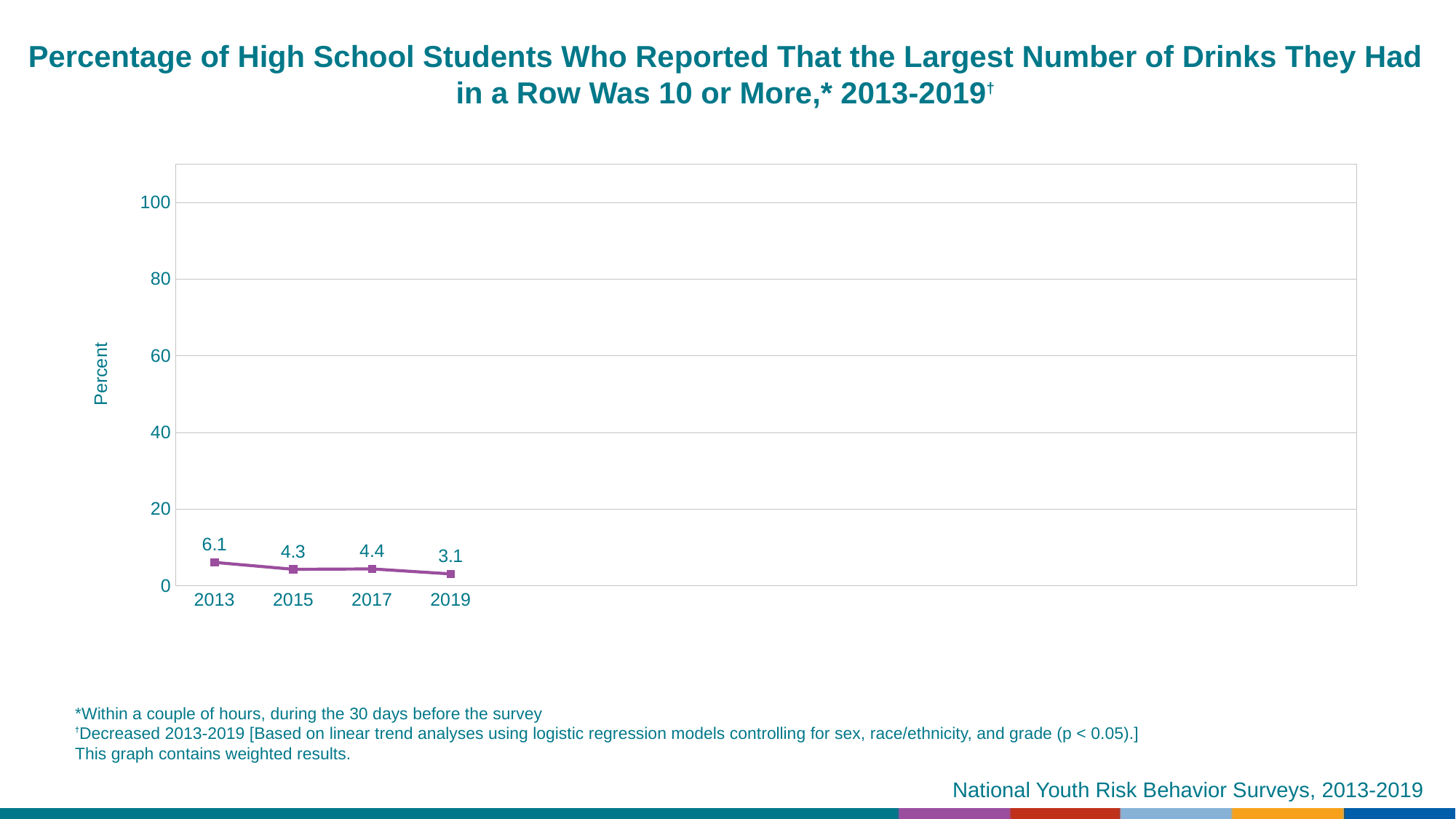
Is the value for 2013 greater or less than 20? less Which is larger, the value for 2015 or the value for 2013? 2013 What value is shown for 2017? 4.4 What was the percentage of high school students who reported that the largest number of drinks they had in a row was 10 or more in 2013? 6.1 Which year has the highest value? 2013 How many years are plotted on the chart? 4 What is the difference between the 2013 value and the 2019 value? 3.0 What value is shown for 2019? 3.1 Which year has the lowest value? 2019 What is the label on the vertical axis? Percent Do the values generally rise or fall from 2013 to 2019? fall What kind of chart is shown on the slide? line chart